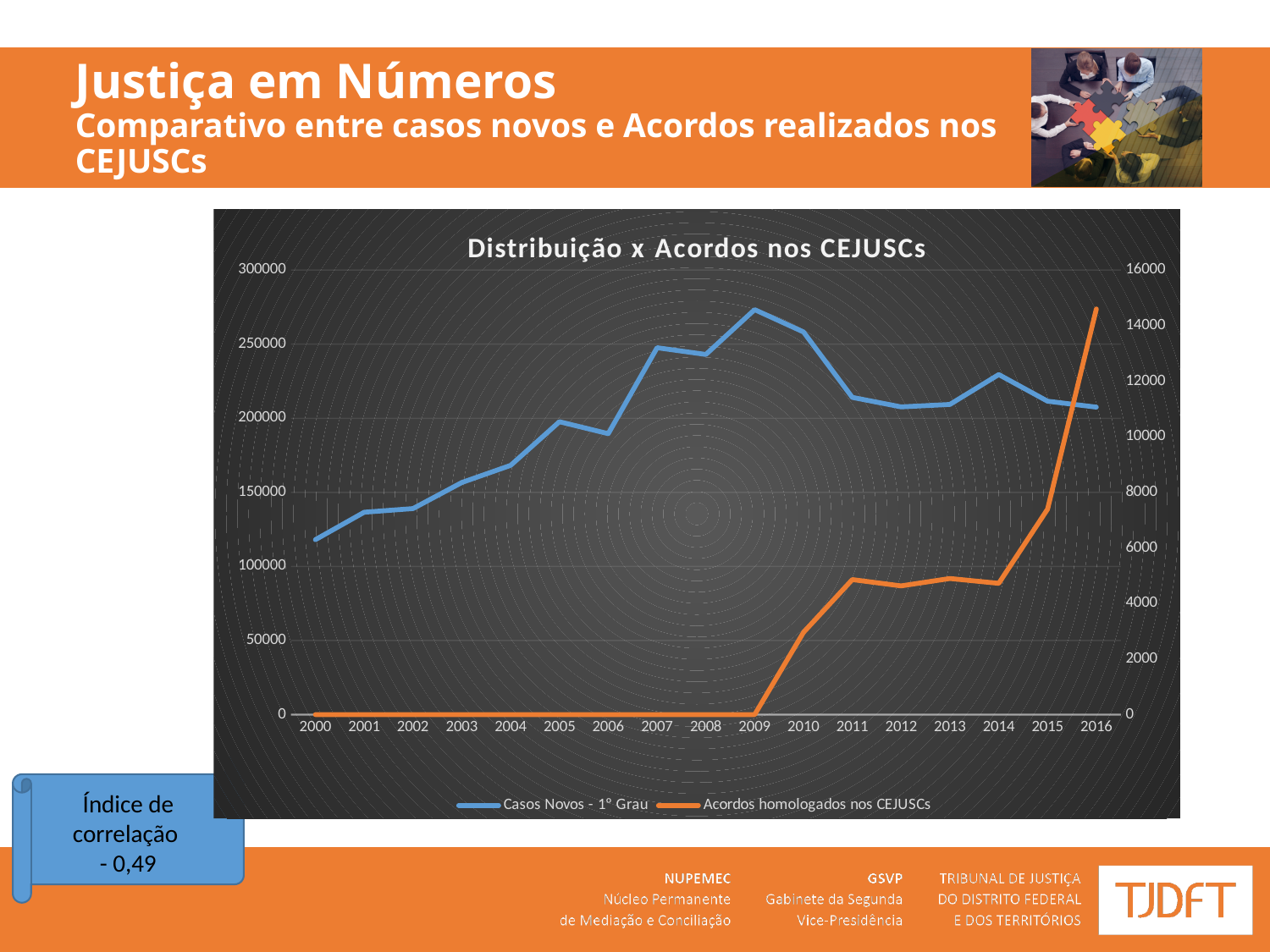
What kind of chart is shown on the slide? Line chart In which year does the 'Acordos homologados nos CEJUSCs' series reach its highest value? 2016 What is the title of the chart? Distribuição x Acordos nos CEJUSCs Which is larger for 'Casos Novos - 1º Grau': the value in 2009 or the value in 2016? 2009 Which series is drawn in orange in the chart? Acordos homologados nos CEJUSCs In which year is the 'Casos Novos - 1º Grau' series at its lowest? 2000 Is the value for 'Acordos homologados nos CEJUSCs' in 2011 greater or less than 6000? less How many years are plotted along the x axis of the chart? 17 How many series does the chart legend list? 2 Does the 'Acordos homologados nos CEJUSCs' series rise or fall from 2014 to 2016? rise Is the value for 'Casos Novos - 1º Grau' in 2009 greater or less than 250000? greater In which year does the 'Casos Novos - 1º Grau' series reach its highest value? 2009